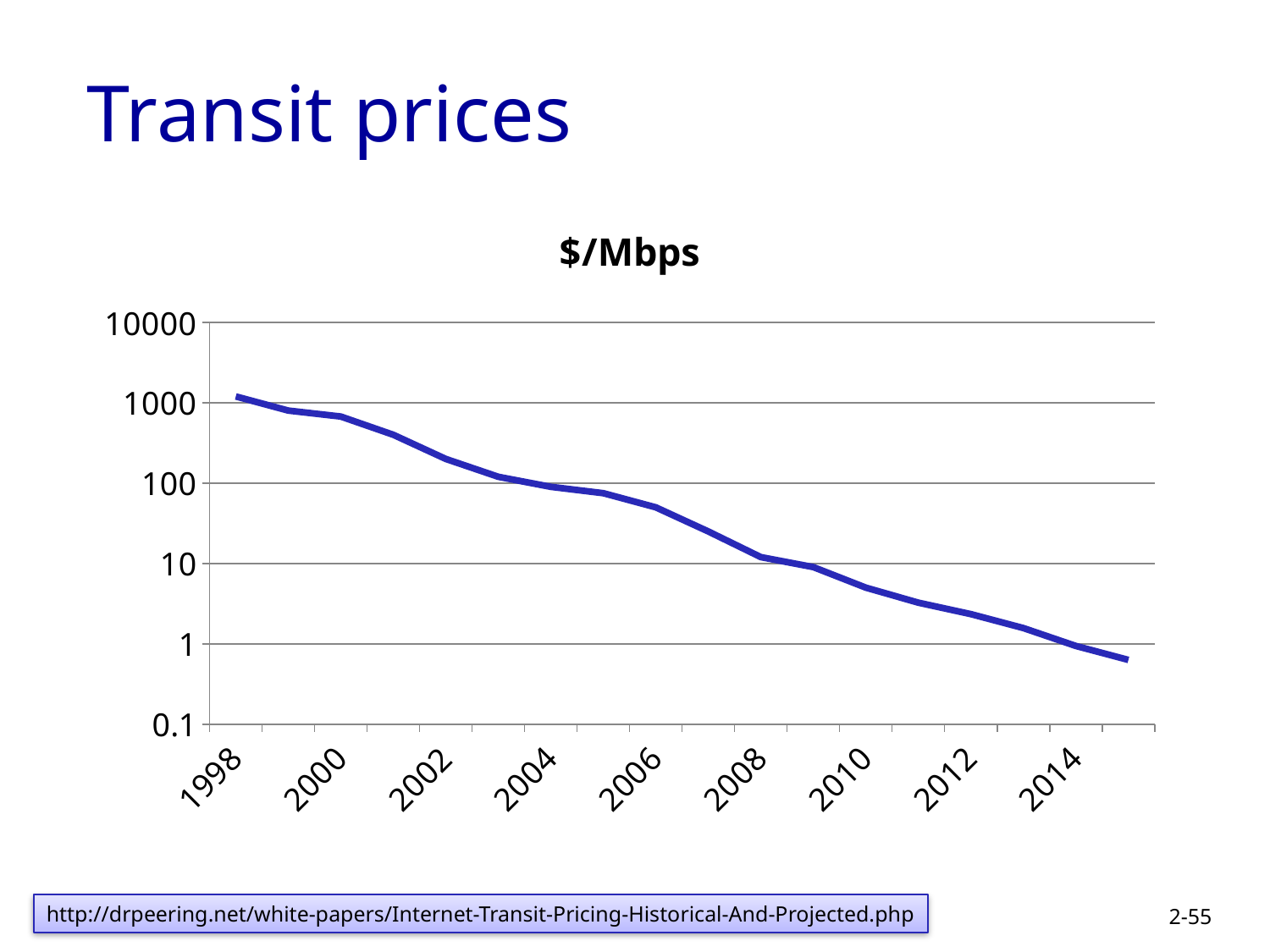
Which year on the x axis has the highest value? 1998 What kind of chart is shown on the slide? line chart What is the highest value shown on the y axis? 10000 Which is larger, the value for 2006 or the value for 2012? 2006 Is the value for 2004 greater or less than 10? greater Is the value for 2008 greater or less than 100? less What is the title of the chart? $/Mbps Do the values rise or fall from 1998 to 2014? fall Is the value for 2014 greater or less than 10? less Which is larger, the value for 2000 or the value for 2010? 2000